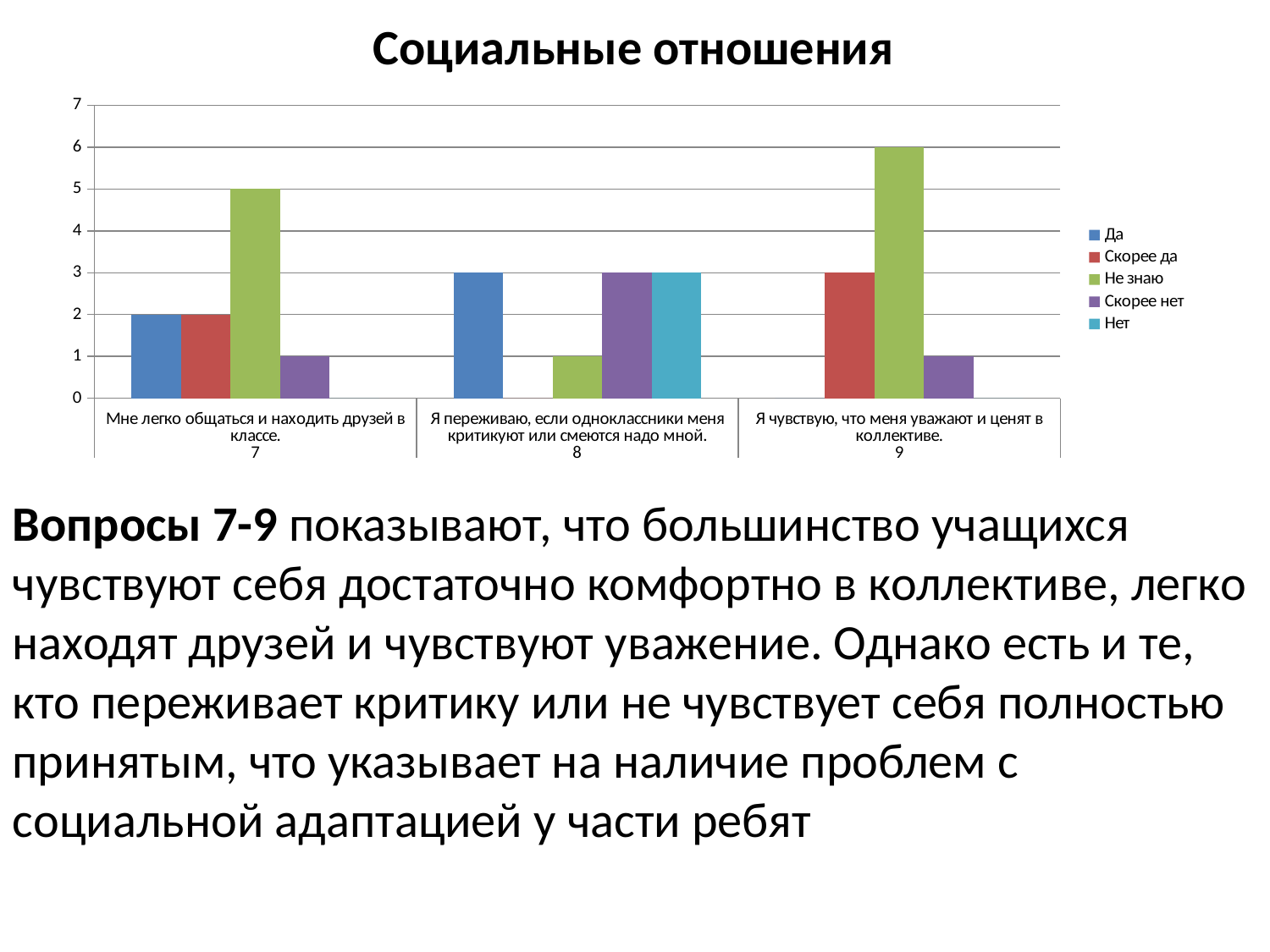
What is the value of "Не знаю" for question 9 ("Я чувствую, что меня уважают и ценят в коллективе.")? 6 What is the difference between the "Не знаю" values for question 9 and question 7? 1 Which question has the highest "Не знаю" value? 9 (Я чувствую, что меня уважают и ценят в коллективе.) What is the value of "Да" for question 8 ("Я переживаю, если одноклассники меня критикуют или смеются надо мной.")? 3 How many series does the legend list? 5 How many question categories are shown on the x axis? 3 What type of chart is shown on the slide? Bar chart What is the title of the chart? Социальные отношения Which series is shown in green in the legend? Не знаю What is the value of "Скорее нет" for question 9? 1 Which is larger for question 7: "Да" or "Скорее нет"? Да What is the value of "Не знаю" for question 7 ("Мне легко общаться и находить друзей в классе.")? 5